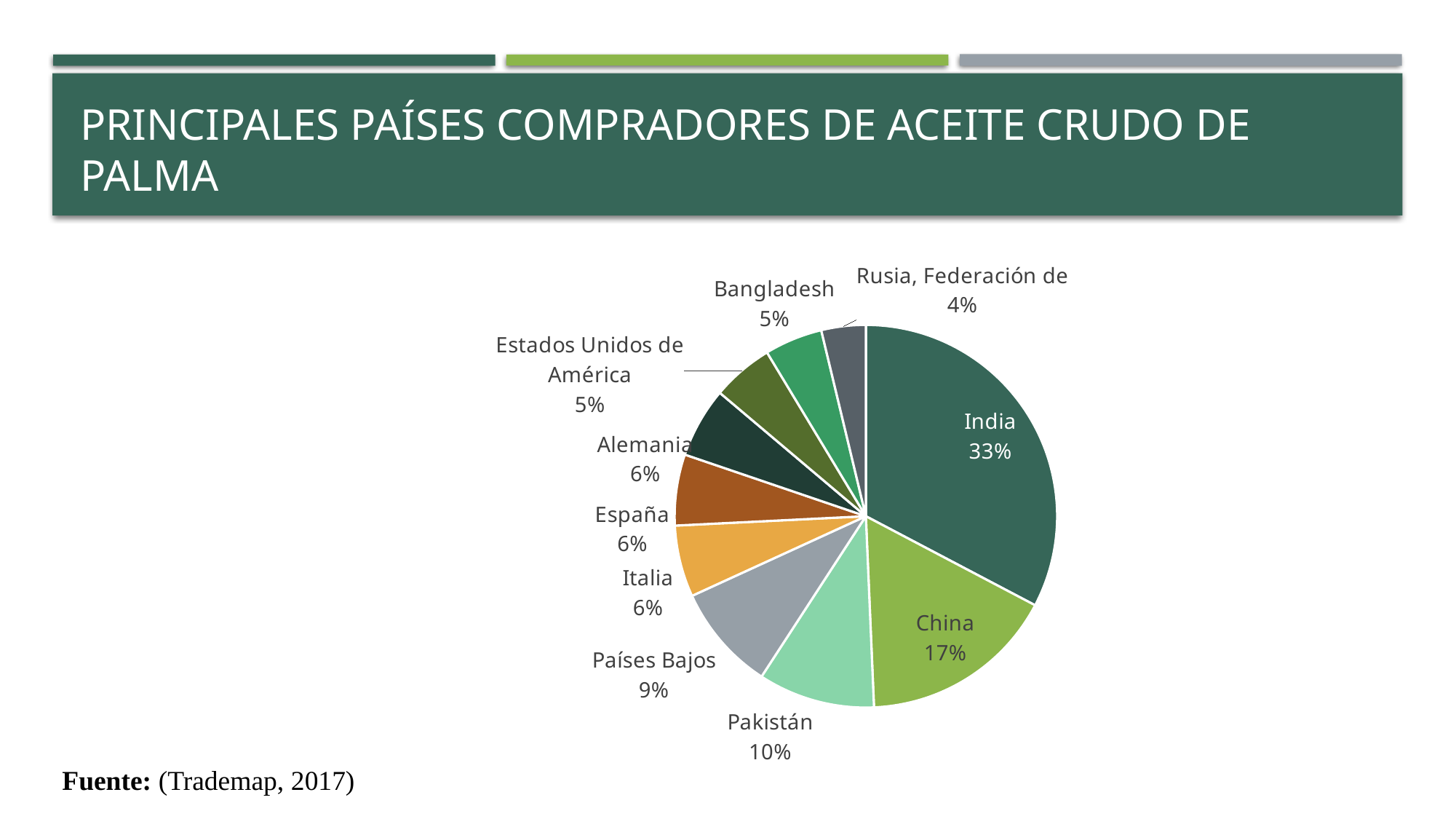
What is the title of the slide containing the chart? PRINCIPALES PAÍSES COMPRADORES DE ACEITE CRUDO DE PALMA Which is larger, the share for Pakistán or the share for Países Bajos? Pakistán How many countries are shown as slices in the pie chart? 10 What kind of chart is shown on the slide? pie chart What is the value shown for China? 17% What share of the pie does India hold? 33% What is the difference in percentage points between India and China? 16 What is the value shown for Países Bajos? 9% Which country has the largest slice of the pie? India Which country has the smallest slice of the pie? Rusia, Federación de What is the value shown for Pakistán? 10% What is the value shown for Rusia, Federación de? 4%